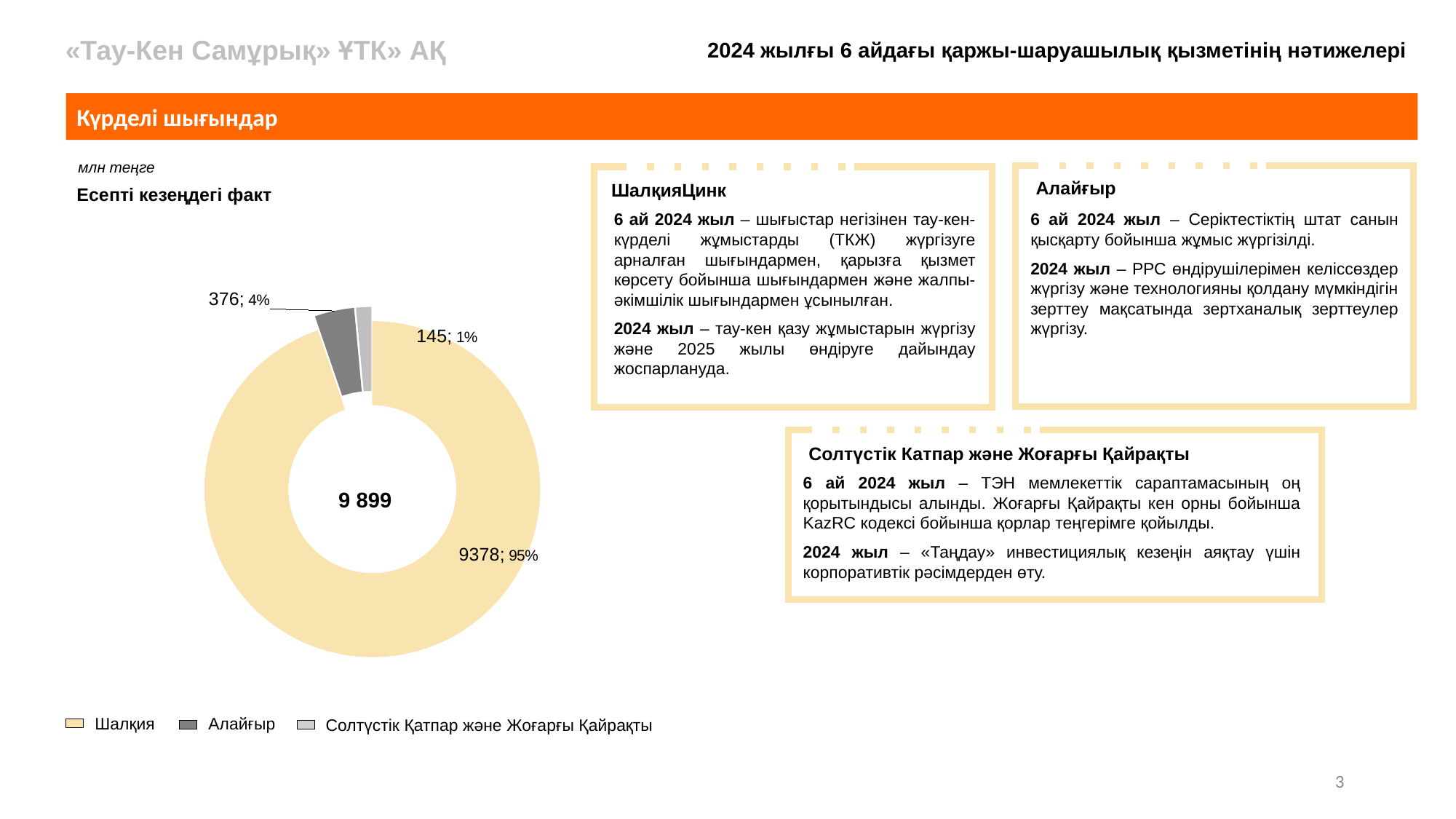
What is the difference between the values for Алайғыр and Солтүстік Қатпар және Жоғарғы Қайрақты? 231 What is the value for Алайғыр in the chart? 376 Which is larger, the value for Алайғыр or the value for Солтүстік Қатпар және Жоғарғы Қайрақты? Алайғыр What total is shown in the centre of the donut chart? 9 899 What share of the pie does Алайғыр account for? 4% What is the value for Шалқия in the chart? 9378 What kind of chart is shown on the slide? Pie (donut) chart How many categories does the chart's legend list? 3 Which category has the largest slice in the chart? Шалқия Which category has the smallest slice in the chart? Солтүстік Қатпар және Жоғарғы Қайрақты What is the value for Солтүстік Қатпар және Жоғарғы Қайрақты in the chart? 145 What share of the pie does Шалқия account for? 95%